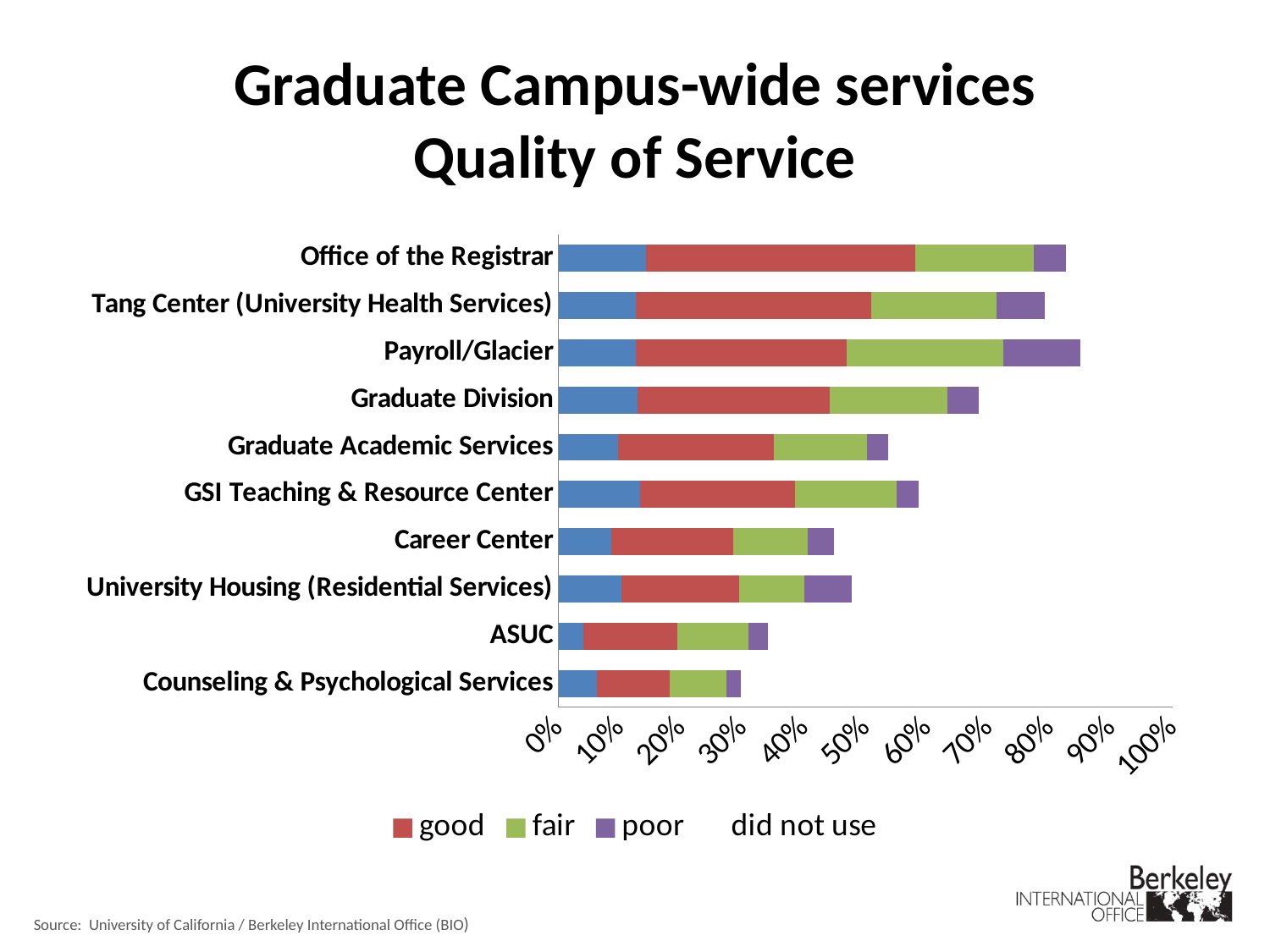
What is the title of the chart? Graduate Campus-wide services Quality of Service How many series does the legend list? 4 Is the total bar for Counseling & Psychological Services greater or less than 40%? less Which colour represents the 'good' series in the legend? red Which has the longer total bar, Tang Center (University Health Services) or Graduate Division? Tang Center (University Health Services) Is the total bar for Office of the Registrar greater or less than 80%? greater Is the total bar for Graduate Division greater or less than 60%? greater How many services (categories) are listed on the chart? 10 What kind of chart is shown on the slide? bar chart Which has the longer total bar, Office of the Registrar or ASUC? Office of the Registrar Which service has the shortest total bar? Counseling & Psychological Services